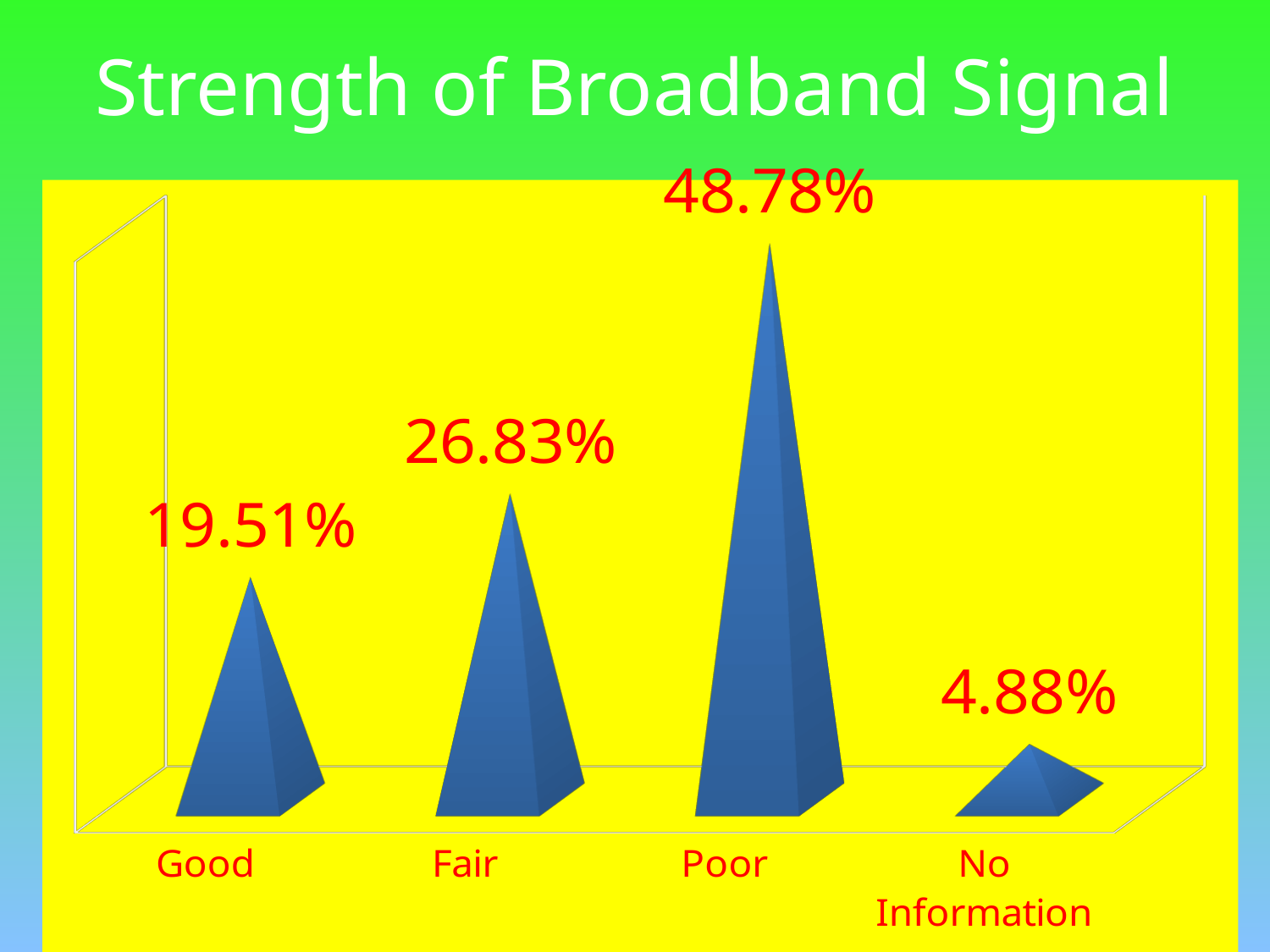
Which is larger, the value for Good or the value for Fair? Fair What is the value for Fair? 26.83% Which category has the highest value? Poor How many categories are shown on the chart? 4 What kind of chart is shown on the slide? Bar chart What is the difference between the values for Poor and Fair? 21.95% What is the value for Poor? 48.78% What is the value for No Information? 4.88% What is the difference between the values for Fair and Good? 7.32% Which category has the lowest value? No Information What is the value for Good? 19.51% What is the title of the chart? Strength of Broadband Signal